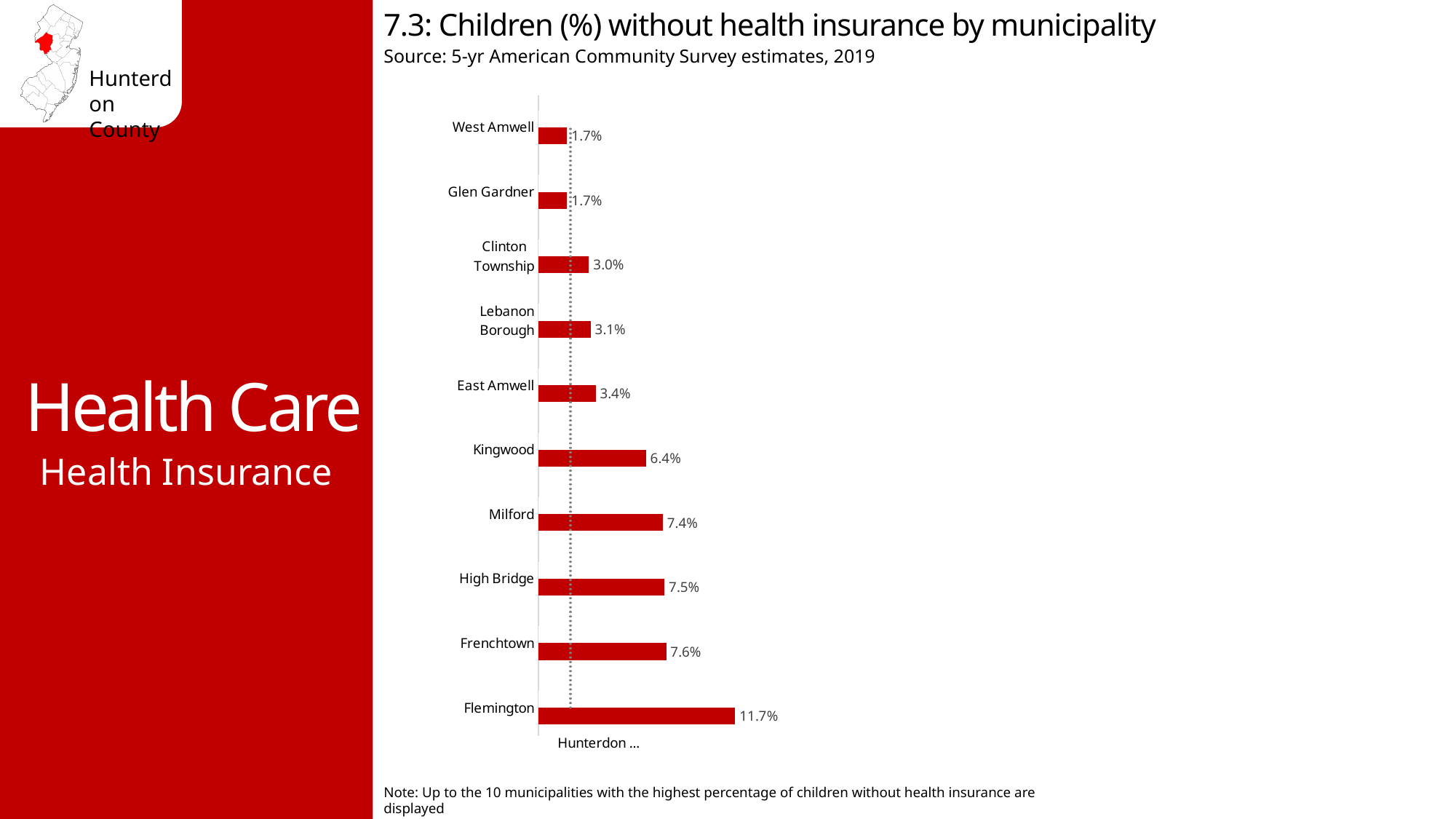
What is the source of the data shown in the chart? 5-yr American Community Survey estimates, 2019 What is the value shown for Kingwood? 6.4% What kind of chart is shown on the slide? Bar chart What percentage of children are without health insurance in Flemington? 11.7% Which has a larger value, High Bridge or East Amwell? High Bridge How many municipalities are shown in the chart? 10 What percentage is shown for Lebanon Borough? 3.1% What is the difference between the values for Flemington and Frenchtown? 4.1% Which municipality has the highest percentage of children without health insurance? Flemington Which has a larger value, Kingwood or Clinton Township? Kingwood What is the title of the chart? 7.3: Children (%) without health insurance by municipality What is the difference between the values for Milford and East Amwell? 4.0%